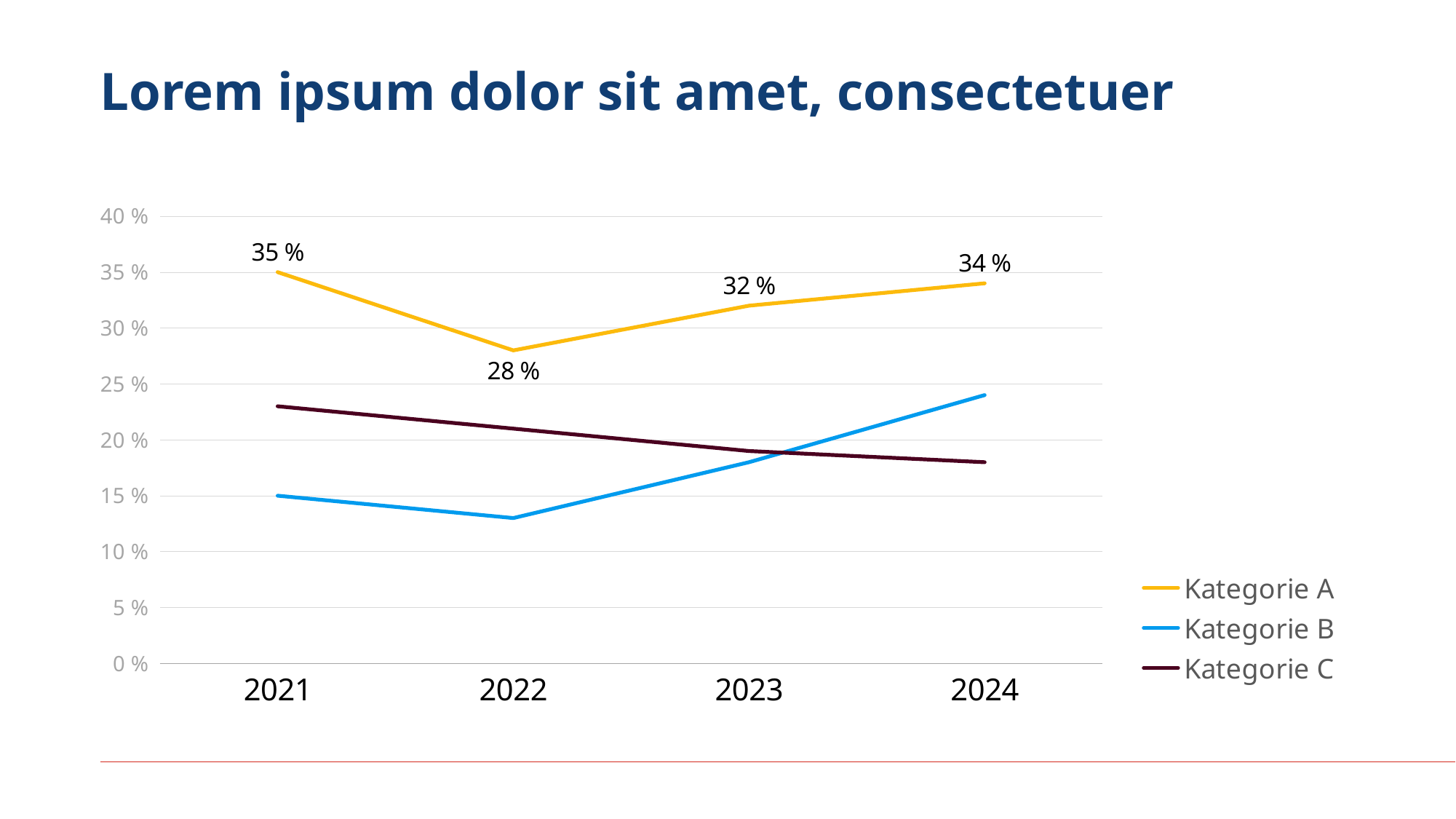
What is the value for Kategorie A in 2022? 28 % Is the value for Kategorie C in 2021 greater or less than 20 %? greater In which year is Kategorie A at its highest? 2021 Is the value for Kategorie B in 2022 greater or less than 15 %? less Which series has the highest value in 2024? Kategorie A What kind of chart is shown on the slide? Line chart What is the difference between the Kategorie A values for 2021 and 2022? 7 % How many series does the legend list? 3 How many years are shown on the x axis? 4 What is the value for Kategorie A in 2024? 34 % What is the value for Kategorie A in 2021? 35 % In which year is Kategorie A at its lowest? 2022